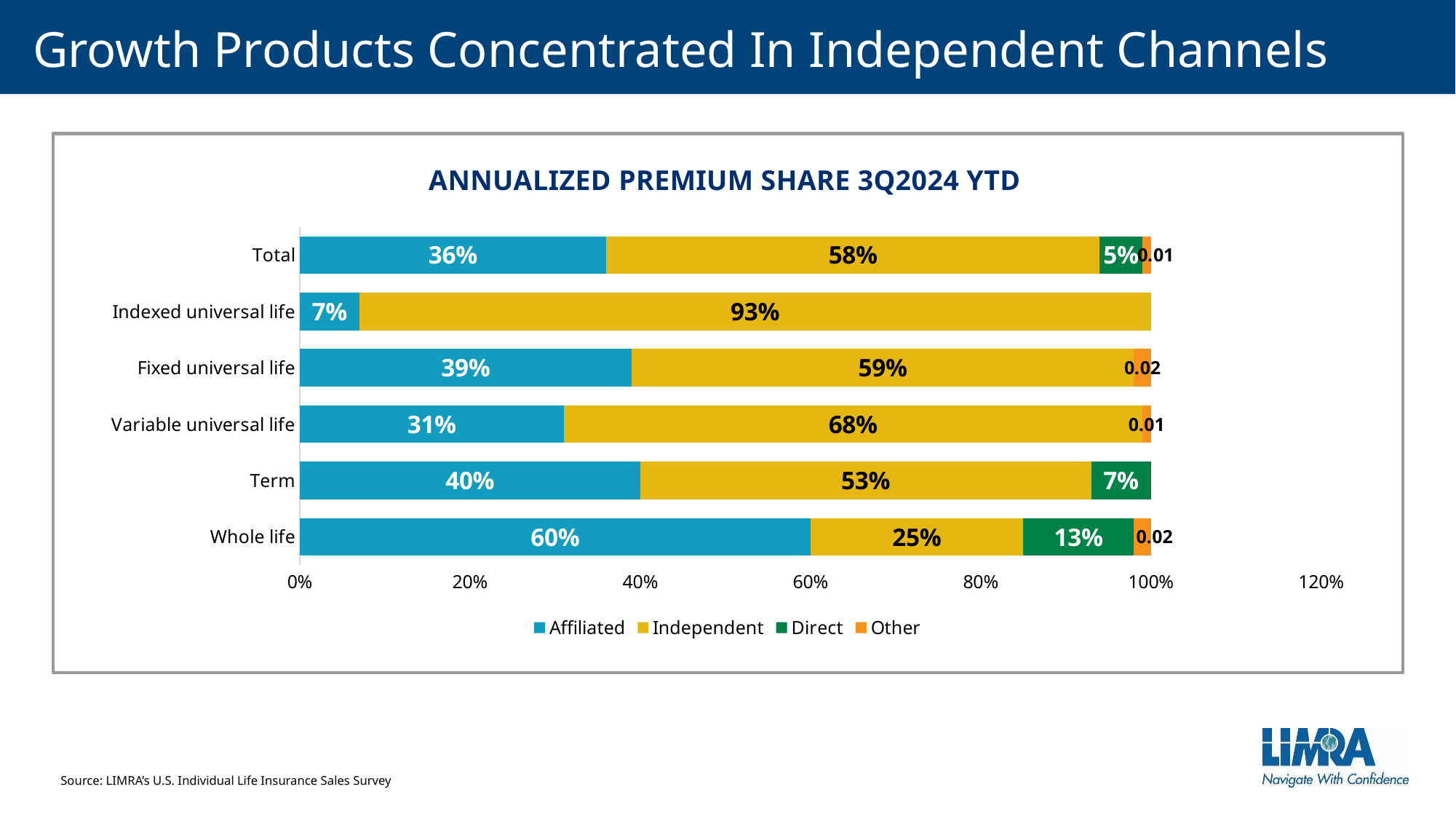
What is the Independent share for the Total bar? 58% Which product has the highest Affiliated share? Whole life How many series does the legend list? 4 What is the Affiliated share for Whole life? 60% What is the difference between the Affiliated and Independent shares for Whole life? 35 percentage points What is the Direct share for Term? 7% What is the title of the chart? ANNUALIZED PREMIUM SHARE 3Q2024 YTD What kind of chart is shown on the slide? Stacked bar chart Which is larger, the Independent share for Term or the Independent share for Fixed universal life? Fixed universal life What is the Independent share for Indexed universal life? 93% Which product has the lowest Affiliated share? Indexed universal life How many product categories are shown on the chart? 6